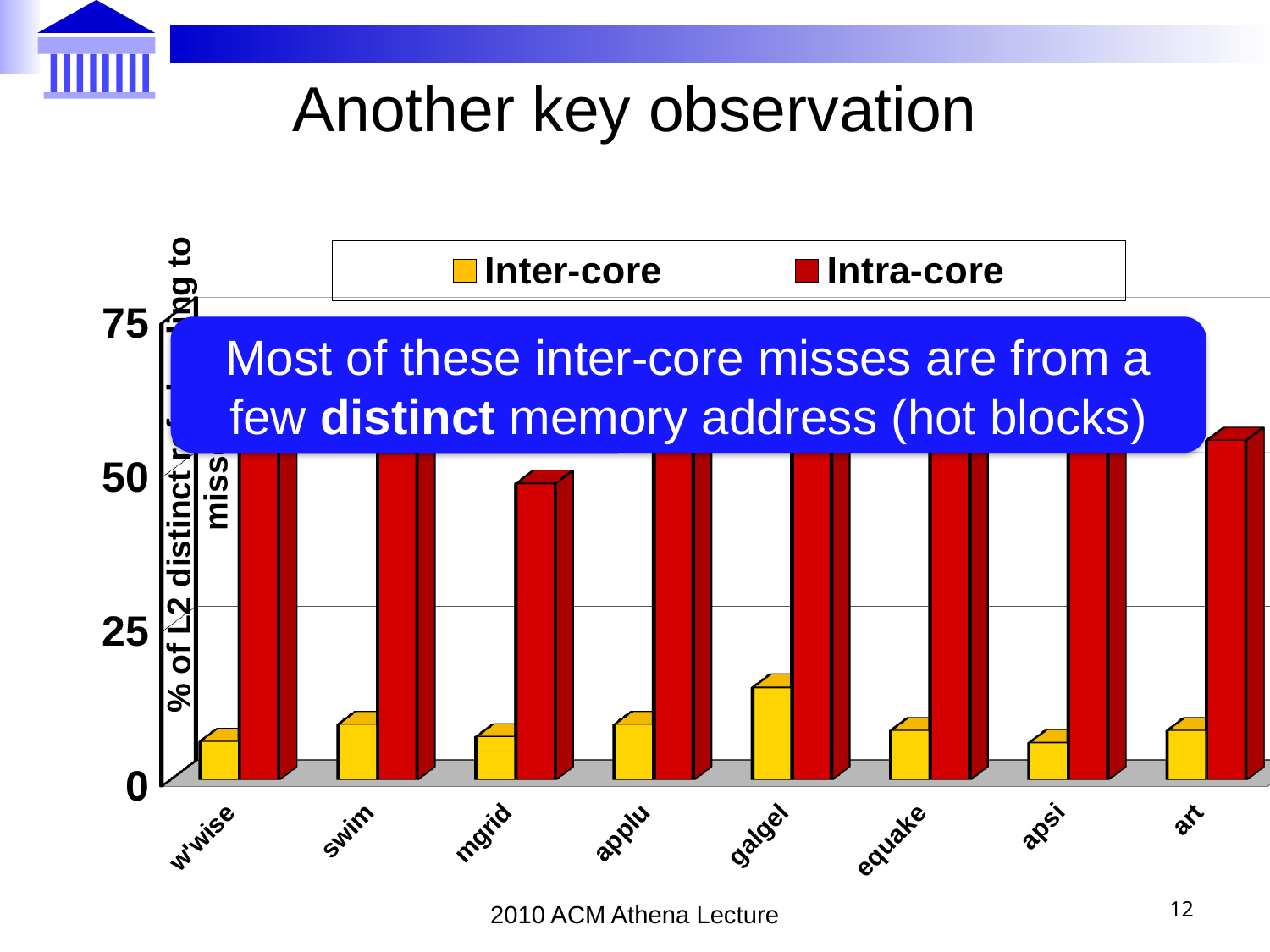
Is the Intra-core value for mgrid greater or less than 50? less What kind of chart is shown on the slide? bar chart Is the Inter-core value for galgel greater or less than 25? less How many series does the chart legend list? 2 Which category has the lowest Intra-core value in the chart? mgrid Is the Intra-core value for art greater or less than 50? greater Which series is drawn in yellow in the chart? Inter-core What are the two series named in the chart legend? Inter-core and Intra-core Which is larger, the Inter-core value for galgel or the Inter-core value for w'wise? galgel How many benchmark categories are shown along the x axis of the chart? 8 Which category has the highest Inter-core value in the chart? galgel Which is larger, the Intra-core value for art or the Intra-core value for mgrid? art